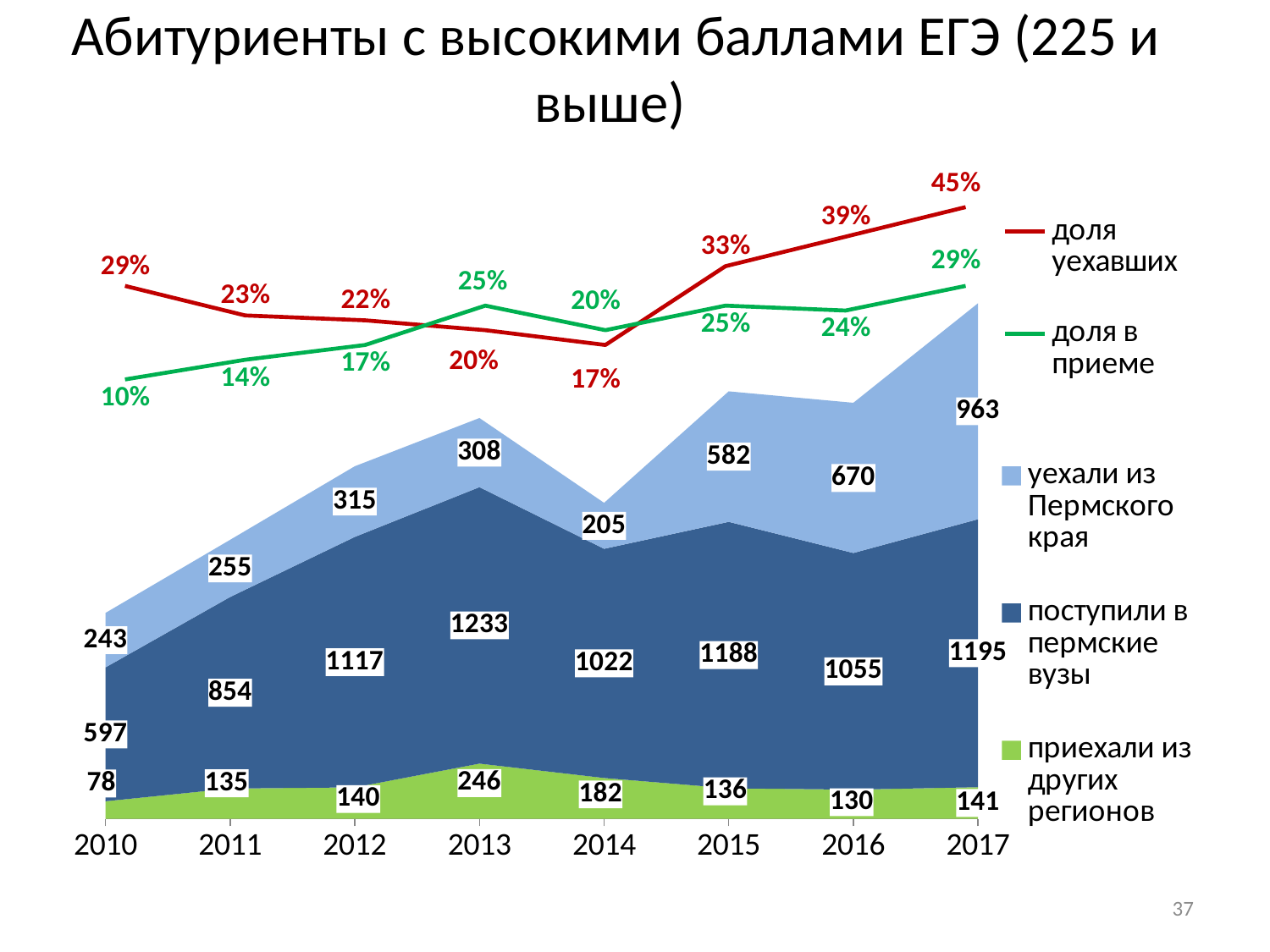
In which year is "уехали из Пермского края" highest? 2017 What is the difference between "уехали из Пермского края" in 2017 and in 2016? 293 How many years are shown on the x axis? 8 What is the "доля уехавших" value in 2014? 17% What is the value for "уехали из Пермского края" in 2017? 963 Which is larger: "приехали из других регионов" in 2013 or in 2014? 2013 What is the "доля в приеме" value in 2017? 29% Does "доля уехавших" rise or fall from 2014 to 2017? rise How many series does the legend list? 5 What is the value for "поступили в пермские вузы" in 2013? 1233 In which year is "поступили в пермские вузы" lowest? 2010 What is the value for "приехали из других регионов" in 2010? 78